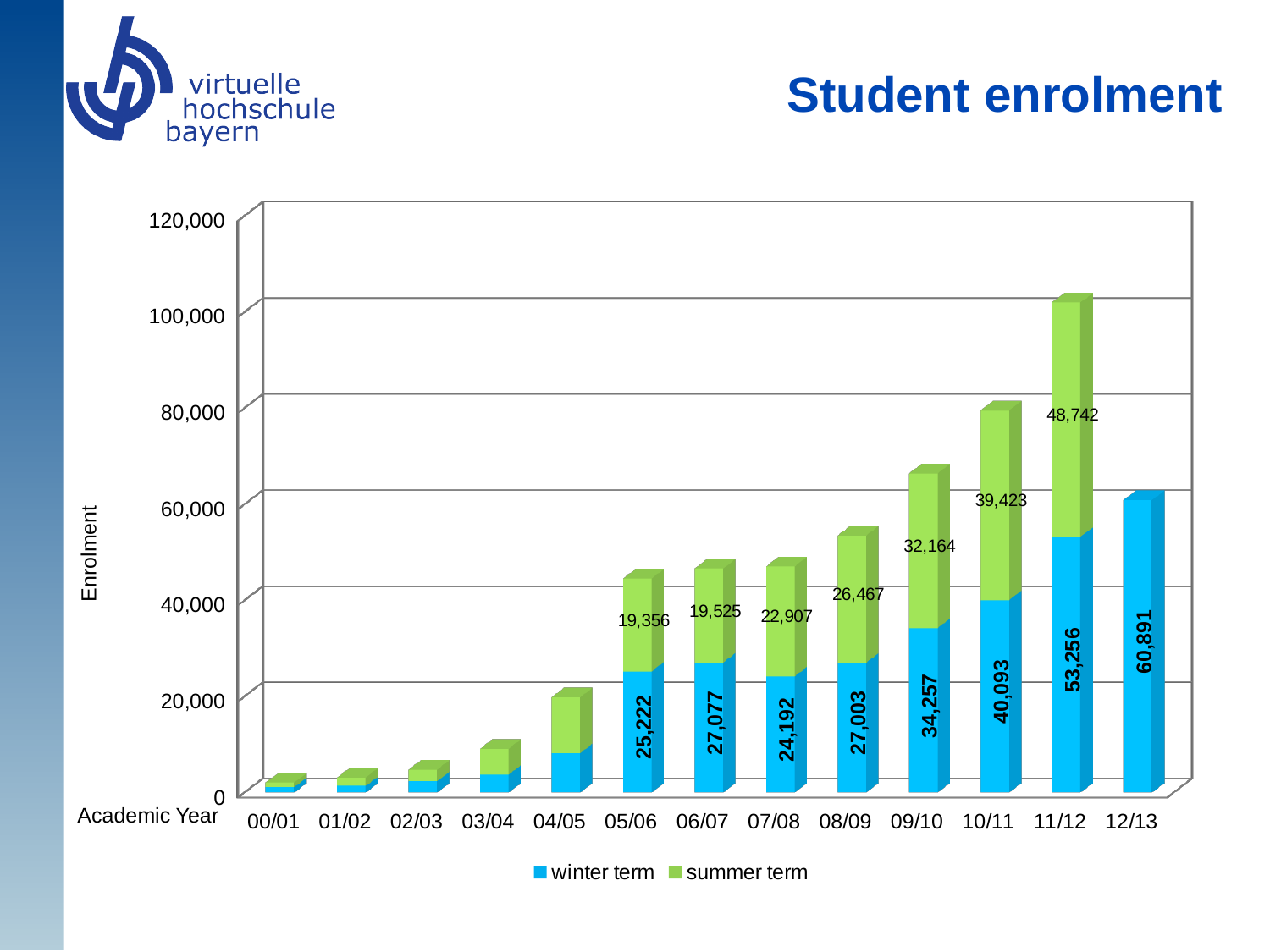
Which academic year has the highest winter term enrolment? 12/13 How many academic years are shown on the x axis? 13 What kind of chart is shown on the slide? Stacked bar chart Among the academic years with a printed winter term label, which has the lowest winter term enrolment? 07/08 What is the total enrolment (winter plus summer term) for 11/12? 101,998 What is the winter term enrolment for 11/12? 53,256 What is the difference between the winter term enrolment in 11/12 and in 10/11? 13,163 What is the summer term enrolment for 09/10? 32,164 Which is larger, the winter term enrolment in 06/07 or in 07/08? 06/07 How many series does the legend list? 2 What is the winter term enrolment for 12/13? 60,891 Is the total enrolment for 03/04 greater or less than 20,000? less